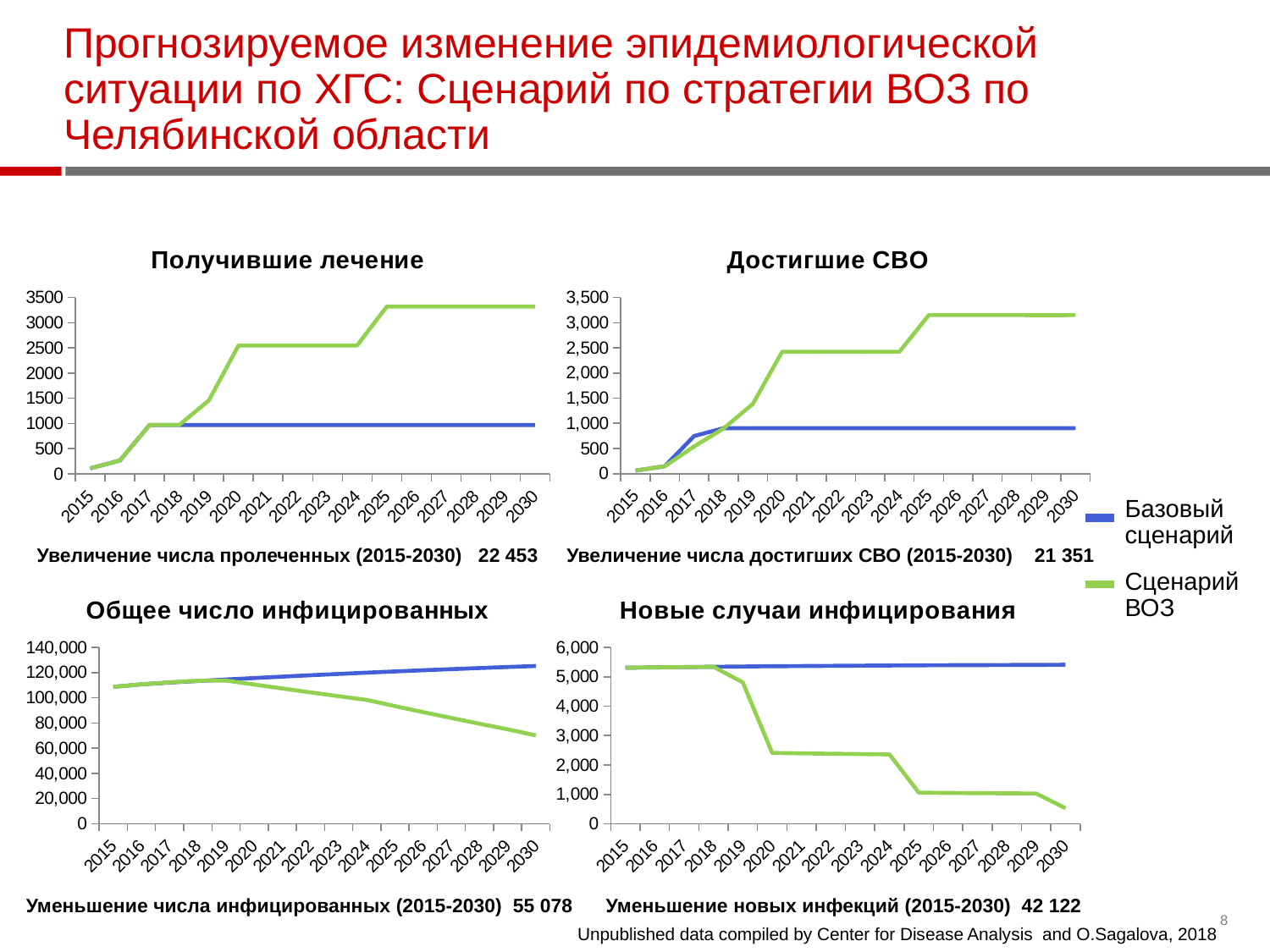
How many years are plotted along the x axis of the "Новые случаи инфицирования" chart? 16 What kind of chart is the "Получившие лечение" chart? line chart In the "Общее число инфицированных" chart, which scenario has the higher value in 2030? Базовый сценарий Which scenario is shown by the green line in the charts? Сценарий ВОЗ In the "Достигшие СВО" chart, is the value of the Сценарий ВОЗ line in 2030 greater or less than 3,000? greater In the "Общее число инфицированных" chart, is the value of the Сценарий ВОЗ line in 2030 greater or less than 80,000? less In the "Новые случаи инфицирования" chart, does the Сценарий ВОЗ line rise or fall from 2015 to 2030? fall In the "Получившие лечение" chart, is the value of the Сценарий ВОЗ line in 2030 greater or less than 3000? greater In the "Новые случаи инфицирования" chart, which scenario has the higher value in 2030? Базовый сценарий How many series does the legend on the slide list? 2